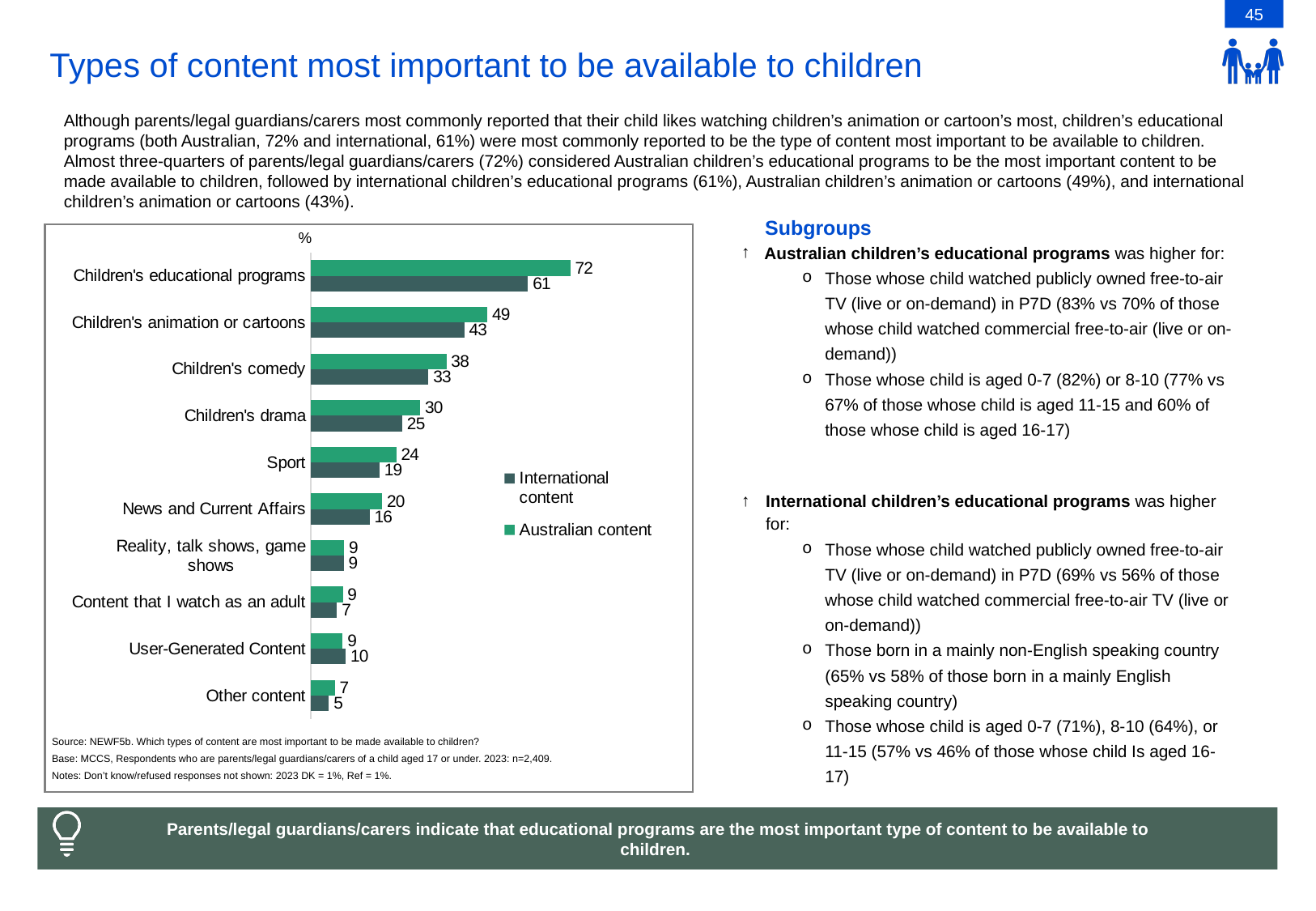
What is the International content value for Children's animation or cartoons? 43 How many series does the chart legend list? 2 Which series is shown in dark teal in the chart legend? International content What is the Australian content value for Children's educational programs? 72 What is the difference between the Australian content and International content values for Children's educational programs? 11 Which category has the highest Australian content value? Children's educational programs What is the International content value for User-Generated Content? 10 What is the International content value for Sport? 19 Which category has the lowest International content value? Other content Which is larger for User-Generated Content: the Australian content value or the International content value? International content How many content categories are shown in the chart? 10 What type of chart is shown on the slide? Bar chart